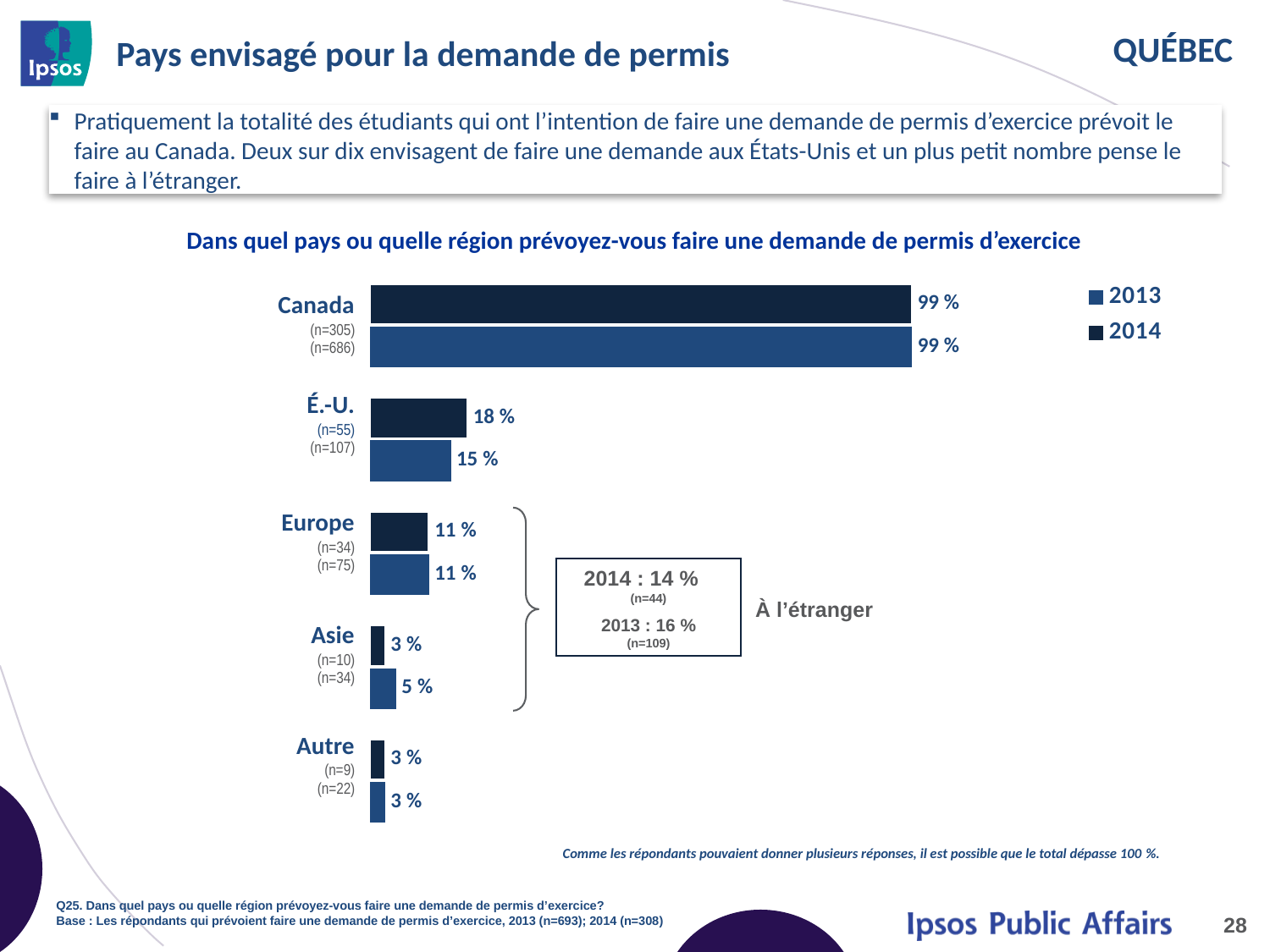
What value is shown for Canada in the chart? 99 % What value is shown on the darker (upper) bar for É.-U.? 18 % How many series does the chart legend list? 2 What are the two entries in the chart legend? 2013 and 2014 What type of chart is shown on the slide? bar chart How many countries or regions are listed as categories in the chart? 5 Which category has the lowest value on the lighter (lower) bars? Autre What value is shown on the lighter (lower) bar for É.-U.? 15 % On the lighter (lower) bars, which is larger: Asie or Autre? Asie Which category has the highest value in the chart? Canada What value is shown for Europe in the chart? 11 % What is the difference between the darker bar and the lighter bar for É.-U.? 3 %